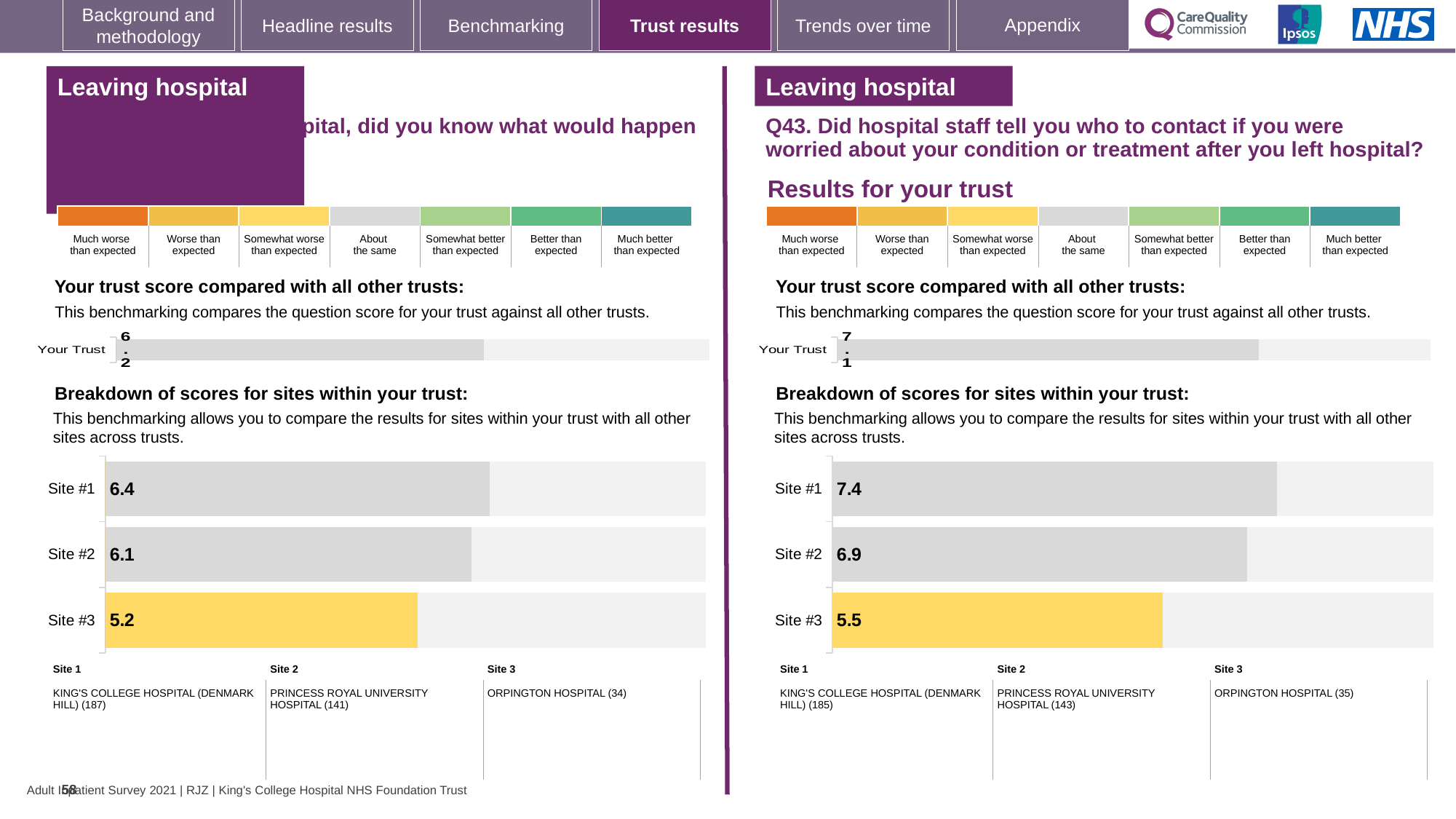
On the right-hand (Q43) site breakdown chart, what is the difference between the scores for Site #1 and Site #3? 1.9 On the right-hand (Q43) site breakdown chart, what is the score for Site #3? 5.5 What type of chart is used for the site breakdown on the right-hand (Q43) side of the slide? Bar chart How many sites are shown on the right-hand (Q43) site breakdown chart? 3 On the left-hand site breakdown chart, what is the score for Site #3? 5.2 On the left-hand site breakdown chart, what is the difference between the scores for Site #1 and Site #2? 0.3 On the left-hand site breakdown chart, which site has the highest score? Site #1 On the left-hand site breakdown chart, what is the score for Site #2? 6.1 On the right-hand (Q43) site breakdown chart, which site has the lowest score? Site #3 On the right-hand (Q43) site breakdown chart, what is the score for Site #1? 7.4 On the left-hand site breakdown chart, which is larger: the score for Site #2 or Site #3? Site #2 On the right-hand (Q43) 'Your Trust' chart, what is the trust score shown? 7.1